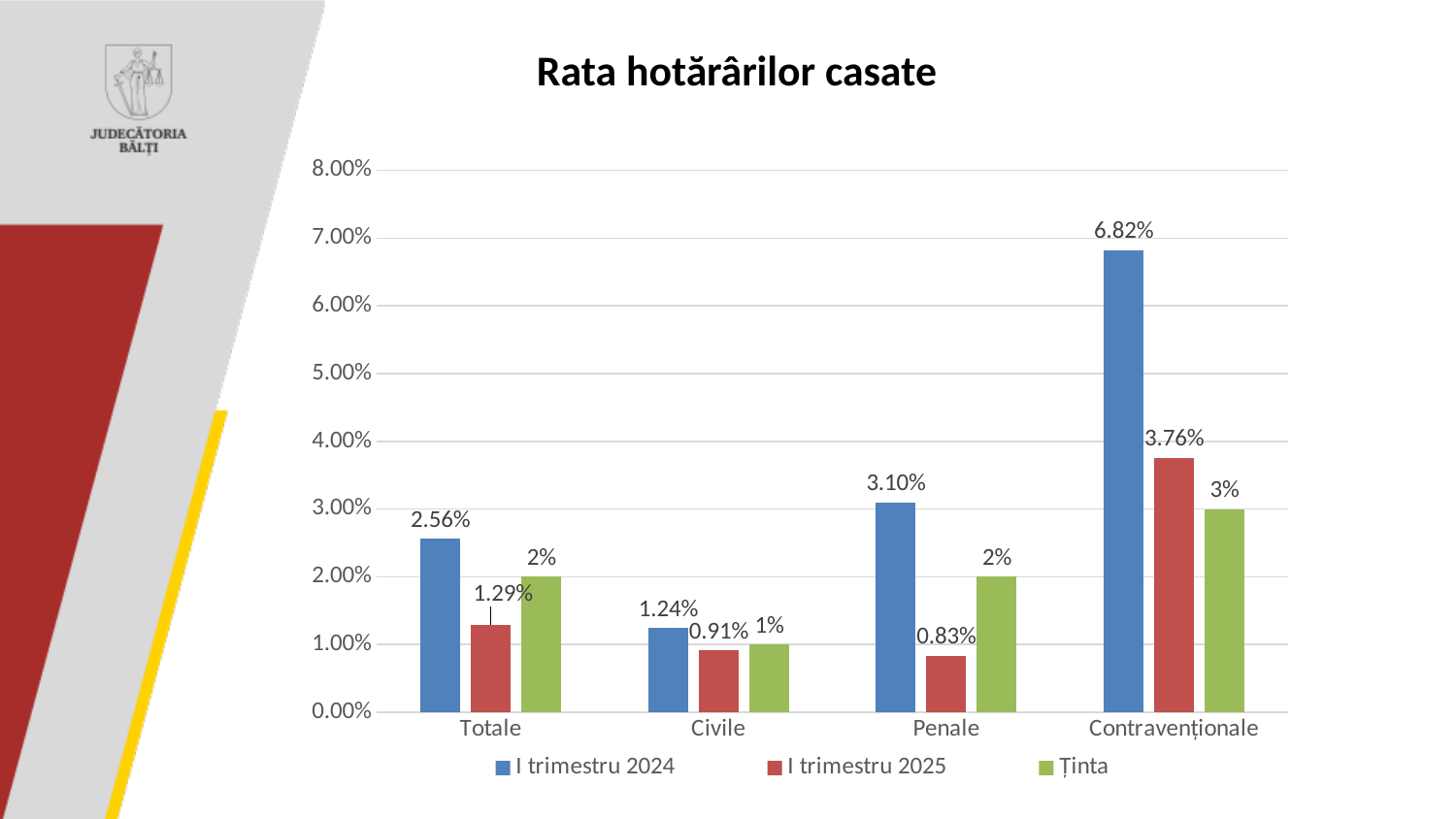
How many series does the legend list? 3 Which category has the lowest value in the I trimestru 2024 series? Civile What is the value for Contravenționale in the I trimestru 2024 series? 6.82% What is the difference between the I trimestru 2024 and I trimestru 2025 values for Totale? 1.27% What is the value for Penale in the I trimestru 2025 series? 0.83% Which category has the highest value in the I trimestru 2025 series? Contravenționale How many categories are shown on the x axis? 4 What kind of chart is shown on the slide? Bar chart Which is larger for Penale: the I trimestru 2024 value or the Ținta value? I trimestru 2024 What is the Ținta value for Civile? 1% Is the I trimestru 2025 value for Contravenționale greater or less than 3.00%? greater What is the title of the chart? Rata hotărârilor casate